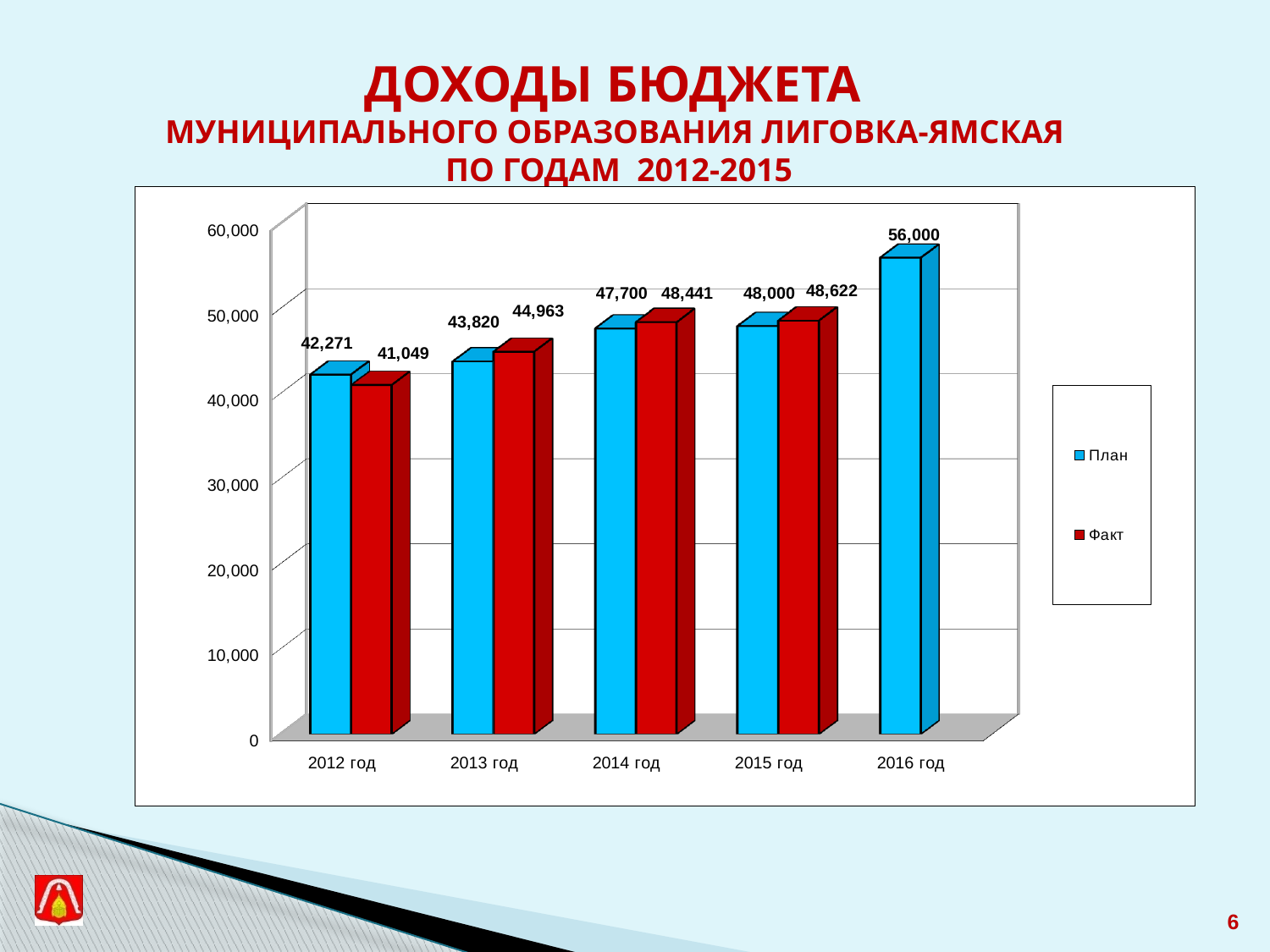
Do the План values rise or fall from 2012 год to 2016 год? rise How many years are shown on the x axis? 5 Which year has the lowest Факт value? 2012 год What is the План value for 2014 год? 47,700 Which year has the highest План value? 2016 год What is the План value for 2016 год? 56,000 How many series does the legend list? 2 What is the difference between the Факт and План values for 2015 год? 622 For 2012 год, which is larger: План or Факт? План What kind of chart is shown on the slide? bar chart What is the Факт value for 2013 год? 44,963 Is the Факт value for 2014 год greater or less than 50,000? less